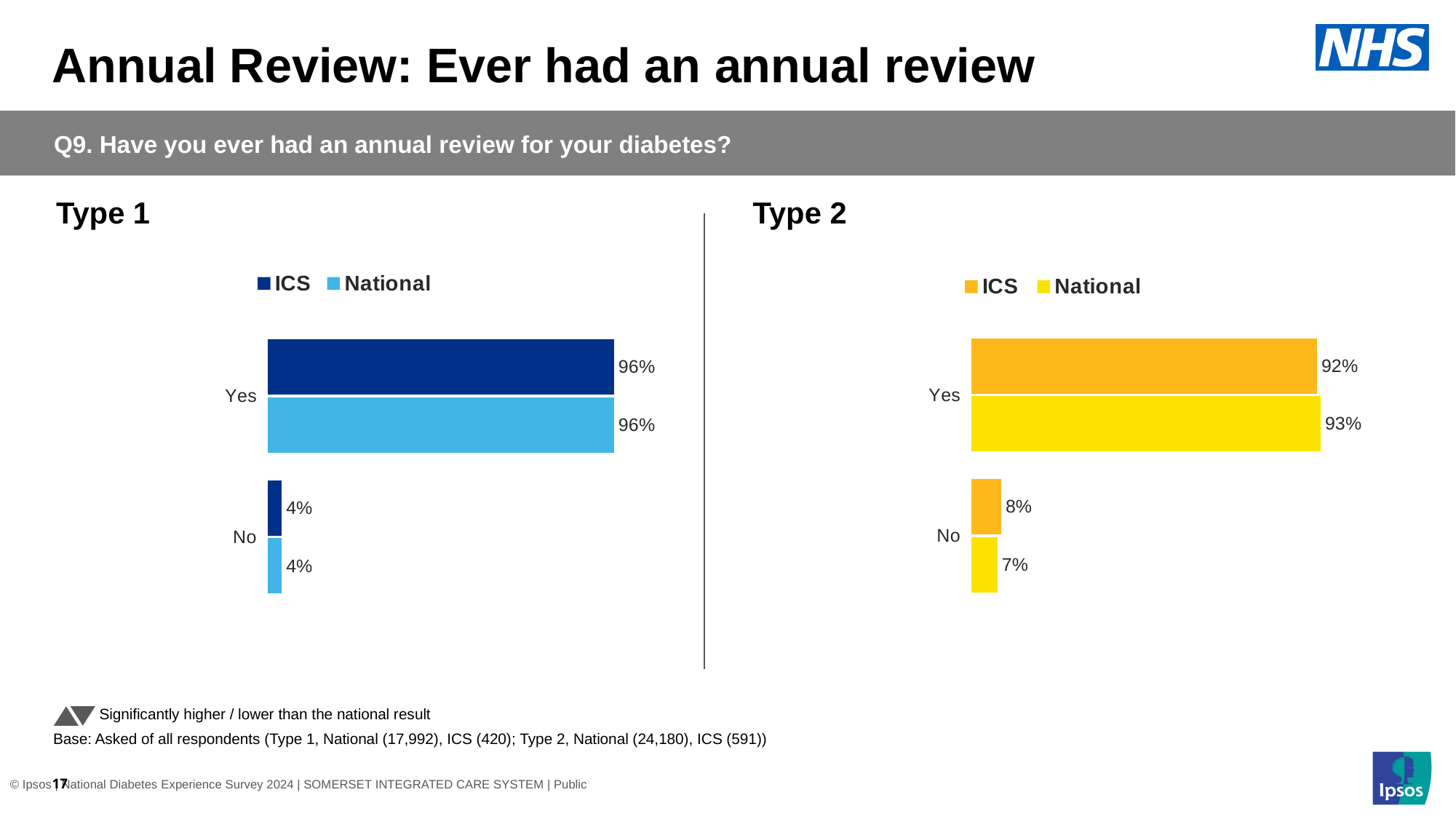
In the Type 1 chart, what is the National value for No? 4% In the Type 2 chart, which is larger for Yes: the ICS value or the National value? National In the Type 2 chart, what is the ICS value for No? 8% In the Type 2 chart, which category has the lowest National value? No What kind of chart is the Type 1 chart? Bar chart In the Type 2 chart, what is the ICS value for Yes? 92% In the Type 2 chart, what is the National value for Yes? 93% How many categories are shown in the Type 1 chart? 2 In the Type 1 chart, what is the ICS value for Yes? 96% In the Type 2 chart, what is the difference between the ICS and National values for No? 1% In the Type 1 chart, which category has the highest ICS value? Yes How many series does the legend of the Type 2 chart list? 2